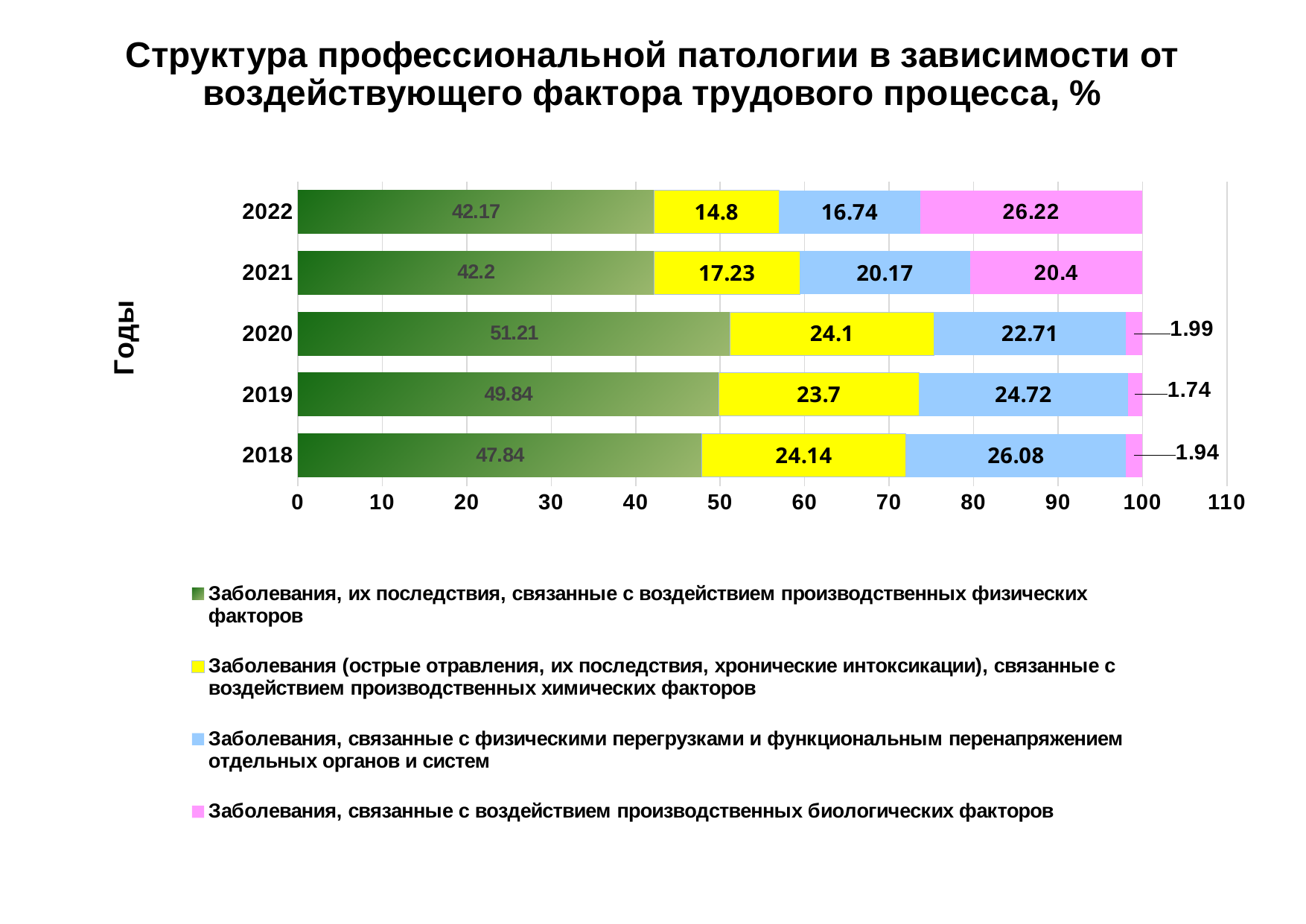
What is the value for the blue series (diseases related to physical overload) in 2019? 24.72 What kind of chart is shown on the slide? Stacked bar chart What is the total of the stacked bar for 2021? 100 What is the difference between the green series value in 2020 and in 2022? 9.04 In which year is the yellow series (chemical factors) lowest? 2022 In which year is the green series (physical production factors) highest? 2020 What is the value for the yellow series (diseases related to chemical factors) in 2018? 24.14 What is the value for the pink series (diseases related to biological factors) in 2022? 26.22 Which is larger: the pink series value in 2022 or in 2021? 2022 How many series does the legend list? 4 What is the value for the green series (diseases related to physical production factors) in 2020? 51.21 How many years are shown on the chart? 5